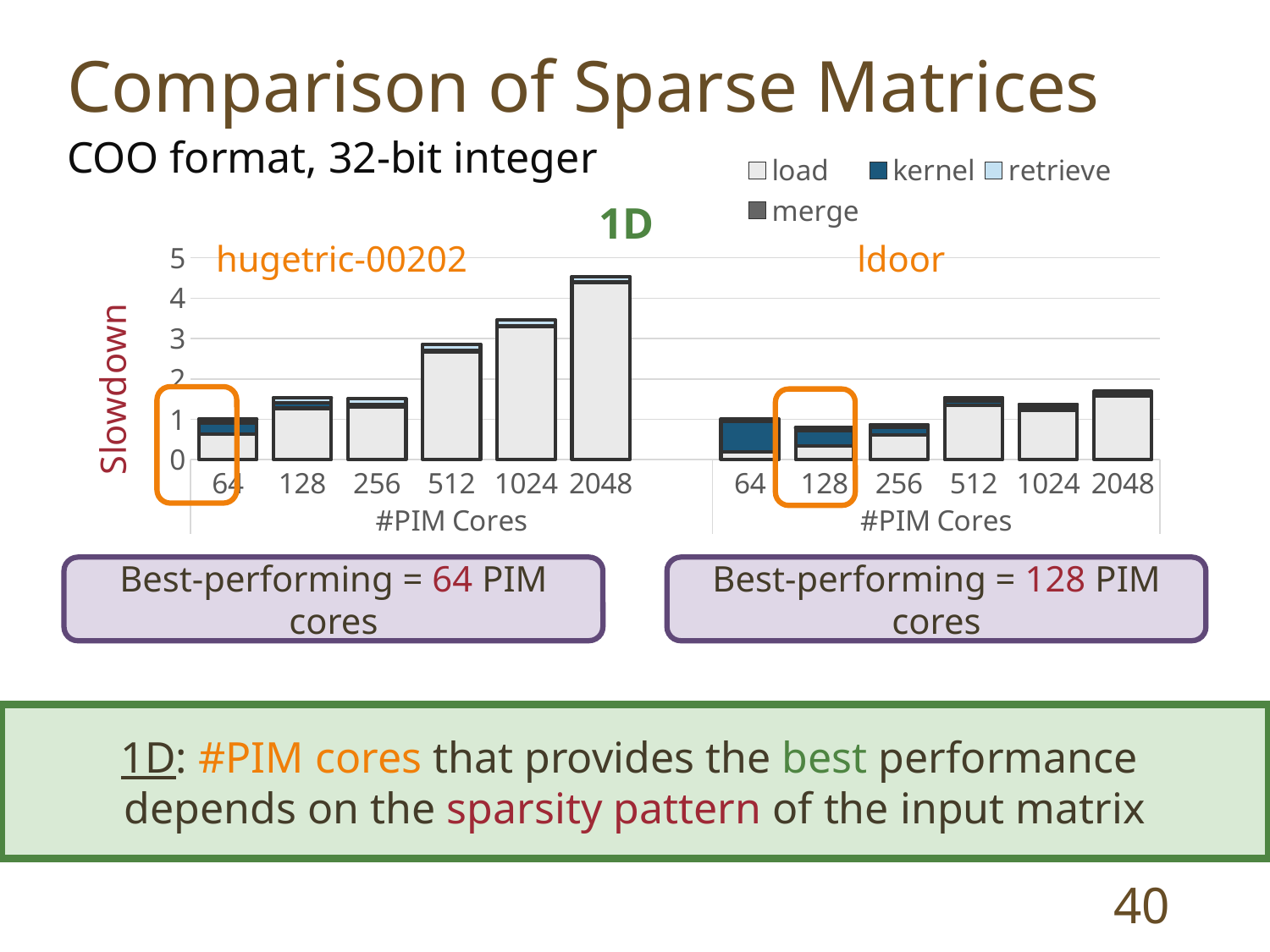
How many #PIM Cores categories are shown in the ldoor chart? 6 What kind of chart is used for hugetric-00202? stacked bar chart In the hugetric-00202 chart, is the slowdown for 512 PIM cores greater or less than 3? less In the hugetric-00202 chart, does the slowdown generally rise or fall as #PIM Cores increases from 64 to 2048? rise In the hugetric-00202 chart, which #PIM Cores value has the highest slowdown? 2048 In the hugetric-00202 chart, which #PIM Cores value has the lowest slowdown? 64 What is the label of the y axis on the charts? Slowdown In the hugetric-00202 chart, is the slowdown for 2048 PIM cores greater or less than 4? greater In the ldoor chart, is the slowdown for 512 PIM cores greater or less than 1? greater In the hugetric-00202 chart, which has the larger slowdown: 1024 or 2048 PIM cores? 2048 In the ldoor chart, which #PIM Cores value has the lowest slowdown? 128 How many series does the legend list? 4